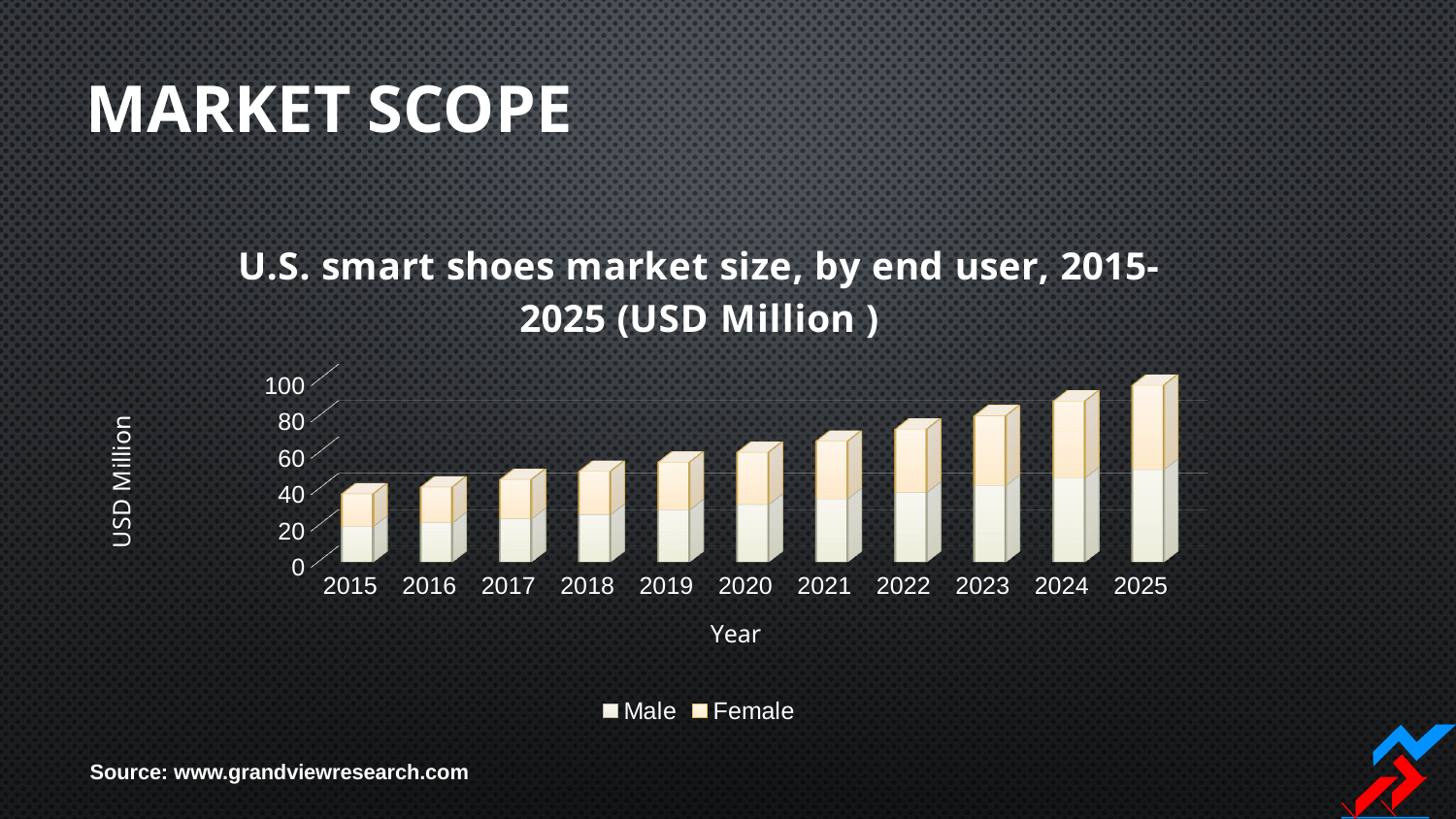
What kind of chart is shown on the slide? stacked bar chart Do the total bar heights rise or fall from 2015 to 2025? rise How many series does the chart's legend list? 2 Which year has the lowest total market size in the chart? 2015 Is the Male value for 2025 greater or less than 40? greater Which year has the highest total market size in the chart? 2025 What is the label on the vertical axis of the chart? USD Million Is the total value for 2017 greater or less than 60? less Is the total value for 2022 greater or less than 60? greater How many years are shown on the x axis of the chart? 11 Is the total value for 2025 larger than the total value for 2015? yes